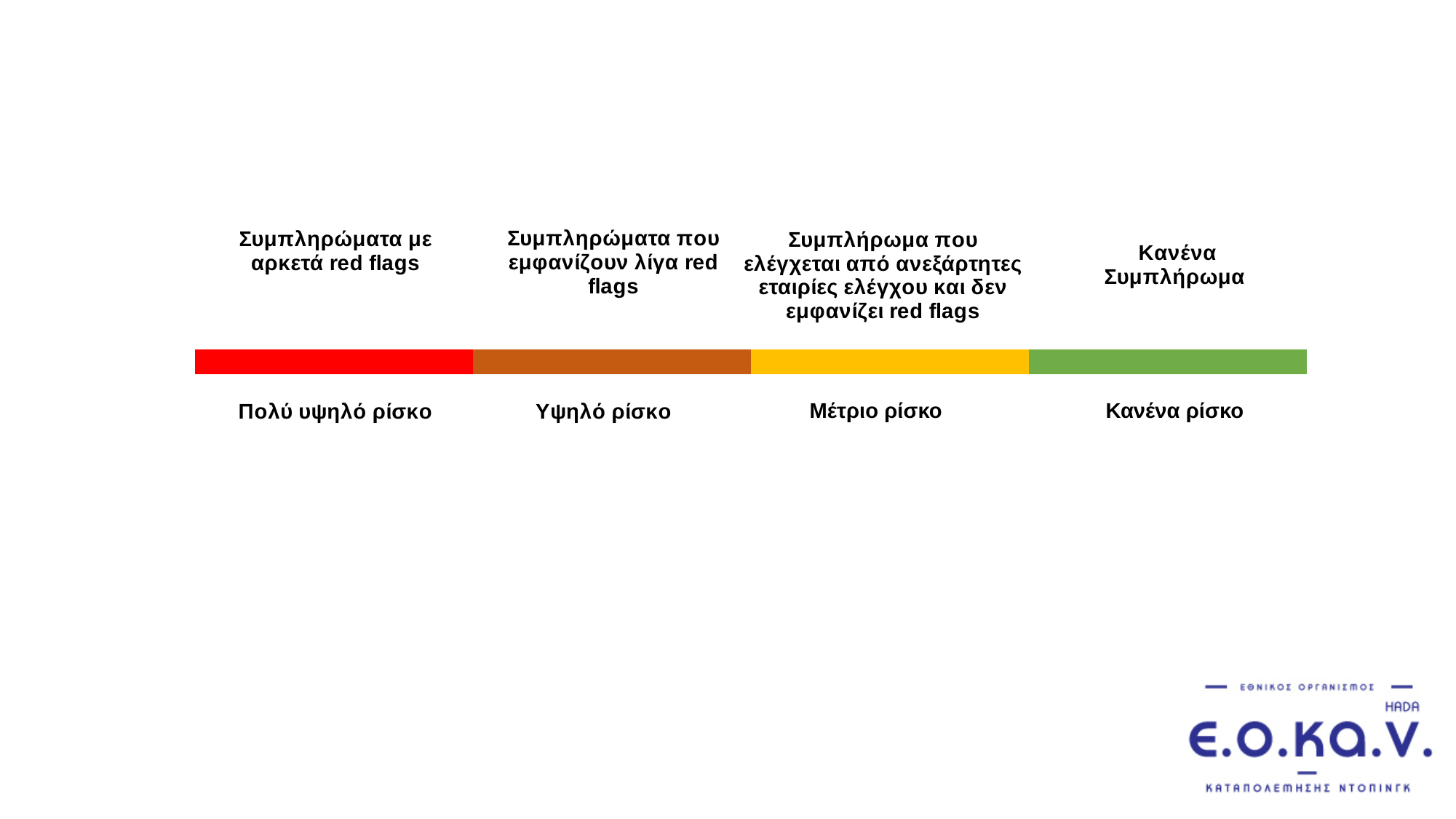
How many coloured segments does the risk scale bar have? 4 Which risk level is shown under the category 'Συμπληρώματα που εμφανίζουν λίγα red flags'? Υψηλό ρίσκο Which risk level corresponds to the yellow segment of the scale? Μέτριο ρίσκο What colour is the segment labelled 'Κανένα ρίσκο'? Green Which risk level is shown under the category 'Κανένα Συμπλήρωμα'? Κανένα ρίσκο Which risk level is shown under the category 'Συμπληρώματα με αρκετά red flags'? Πολύ υψηλό ρίσκο What colour is the segment labelled 'Πολύ υψηλό ρίσκο'? Red